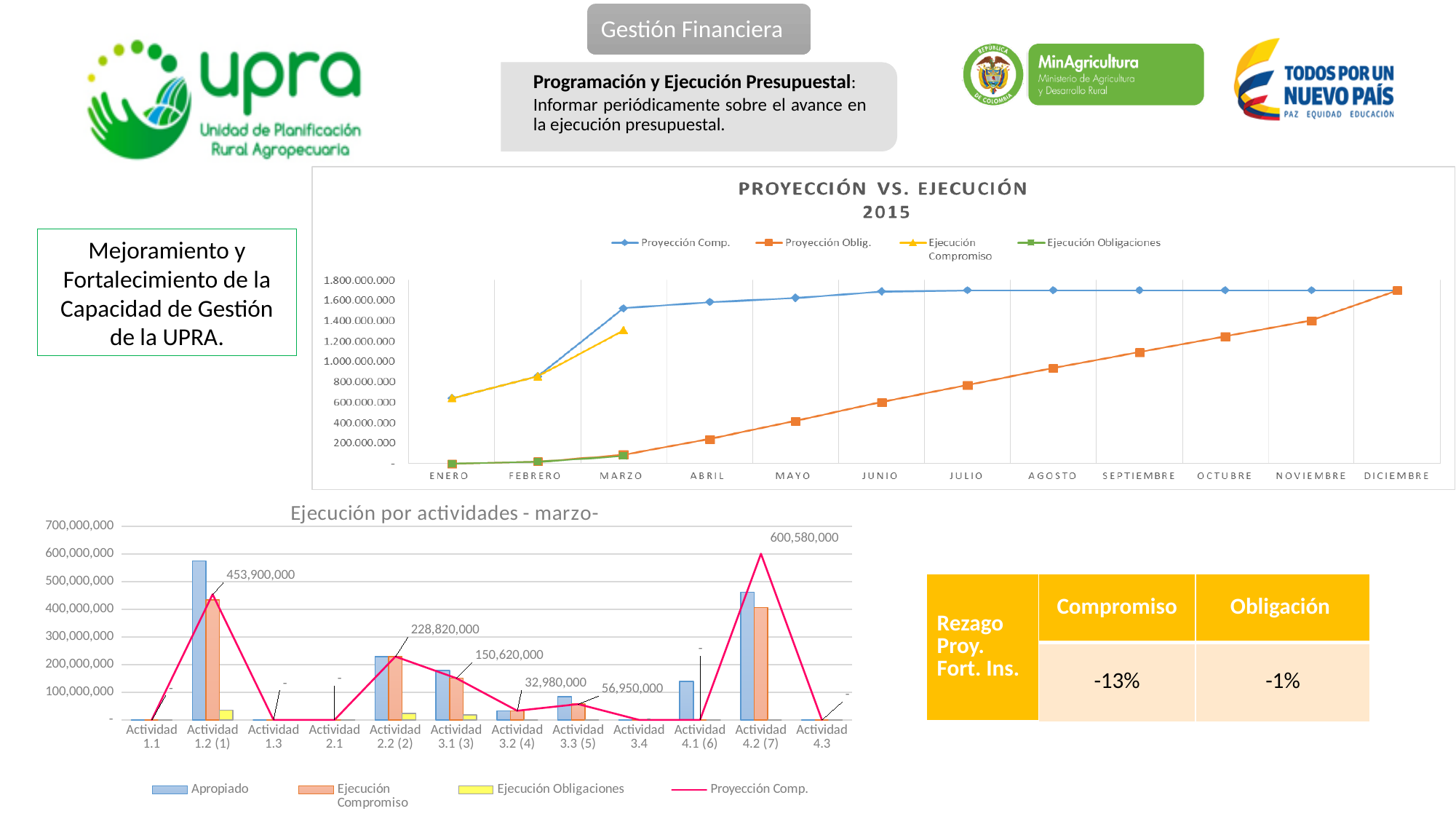
How many months are shown on the x axis of the 'PROYECCIÓN VS. EJECUCIÓN 2015' chart? 12 In the 'Ejecución por actividades - marzo-' chart, which activity has the highest Proyección Comp. value? Actividad 4.2 (7) In the 'Ejecución por actividades - marzo-' chart, is the Apropiado value for Actividad 1.2 (1) greater or less than 500,000,000? greater In the 'Ejecución por actividades - marzo-' chart, what is the Proyección Comp. value for Actividad 4.2 (7)? 600,580,000 In the 'PROYECCIÓN VS. EJECUCIÓN 2015' chart, does the Proyección Oblig. series rise or fall from Enero to Diciembre? Rise In the 'Ejecución por actividades - marzo-' chart, what is the difference between the Proyección Comp. values for Actividad 4.2 (7) and Actividad 1.2 (1)? 146,680,000 What type of chart is the 'PROYECCIÓN VS. EJECUCIÓN 2015' chart? Line chart In the 'PROYECCIÓN VS. EJECUCIÓN 2015' chart, is the Ejecución Compromiso value for Marzo greater or less than 1.000.000.000? greater In the 'Ejecución por actividades - marzo-' chart, which is larger: the Proyección Comp. value for Actividad 3.1 (3) or for Actividad 3.3 (5)? Actividad 3.1 (3) In the 'Ejecución por actividades - marzo-' chart, what is the Proyección Comp. value for Actividad 2.2 (2)? 228,820,000 How many series does the legend of the 'PROYECCIÓN VS. EJECUCIÓN 2015' chart list? 4 In the 'PROYECCIÓN VS. EJECUCIÓN 2015' chart, is the Proyección Comp. value for Julio greater or less than 1.600.000.000? greater